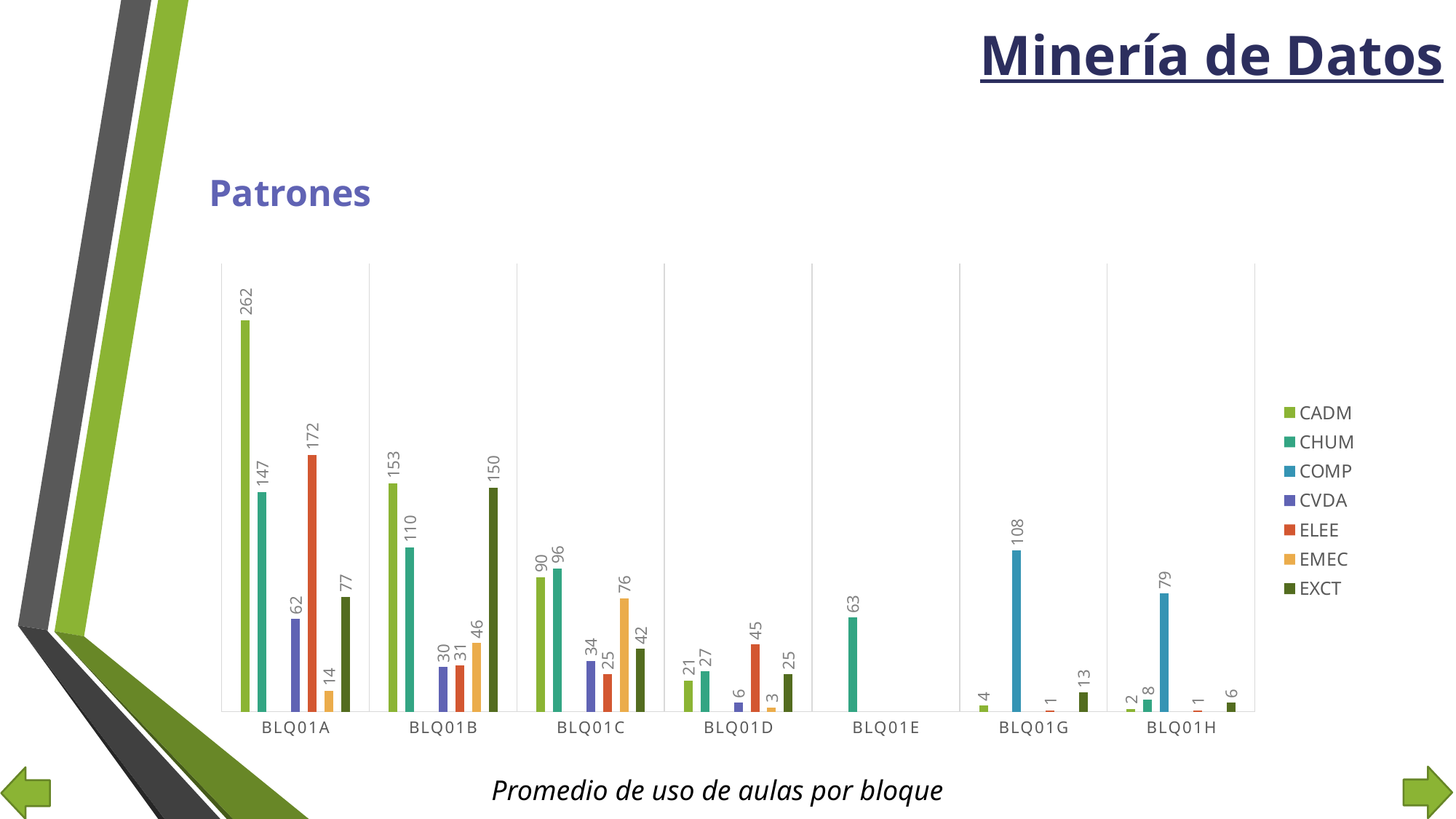
Which series has the lowest value in BLQ01D? EMEC What is the value for COMP in BLQ01G? 108 What is the difference between the CADM and CHUM values in BLQ01B? 43 What is the value for ELEE in BLQ01A? 172 What kind of chart is shown on the slide? Bar chart What is the value for CADM in BLQ01A? 262 What is the value for EXCT in BLQ01B? 150 What is the value for CHUM in BLQ01E? 63 Which series has the highest value in BLQ01C? CHUM Which is larger: the COMP value in BLQ01G or the COMP value in BLQ01H? BLQ01G How many series does the legend list? 7 How many categories (blocks) are shown on the x axis? 7